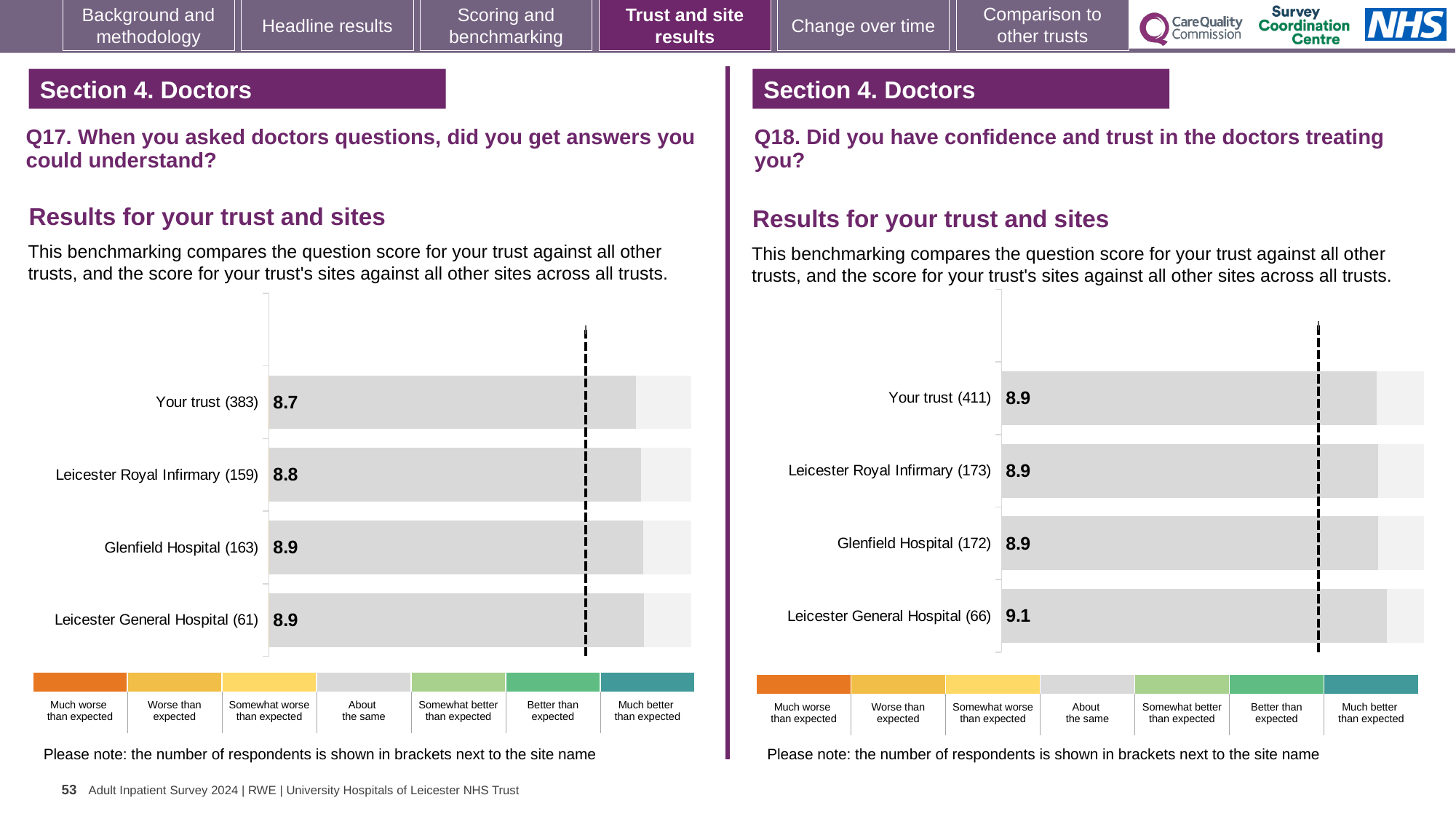
In the Q18 chart on the right, what is the score for Glenfield Hospital? 8.9 In the Q18 chart on the right, what is the difference between the score for Leicester General Hospital and the score for Your trust? 0.2 In the Q18 chart on the right, which category has the highest score? Leicester General Hospital In the Q18 chart on the right, what is the score for Leicester General Hospital? 9.1 In the Q17 chart on the left, what is the score for Your trust? 8.7 In the Q17 chart on the left, which category has the lowest score? Your trust In the Q17 chart on the left, what is the difference between the score for Glenfield Hospital and the score for Your trust? 0.2 In the Q17 chart on the left, which has the higher score, Your trust or Leicester Royal Infirmary? Leicester Royal Infirmary In the Q17 chart on the left, what is the score for Leicester Royal Infirmary? 8.8 What kind of chart is the Q17 chart on the left? Bar chart How many categories are plotted in the Q18 chart on the right? 4 In the Q18 chart on the right, how many respondents are shown in brackets for Your trust? 411